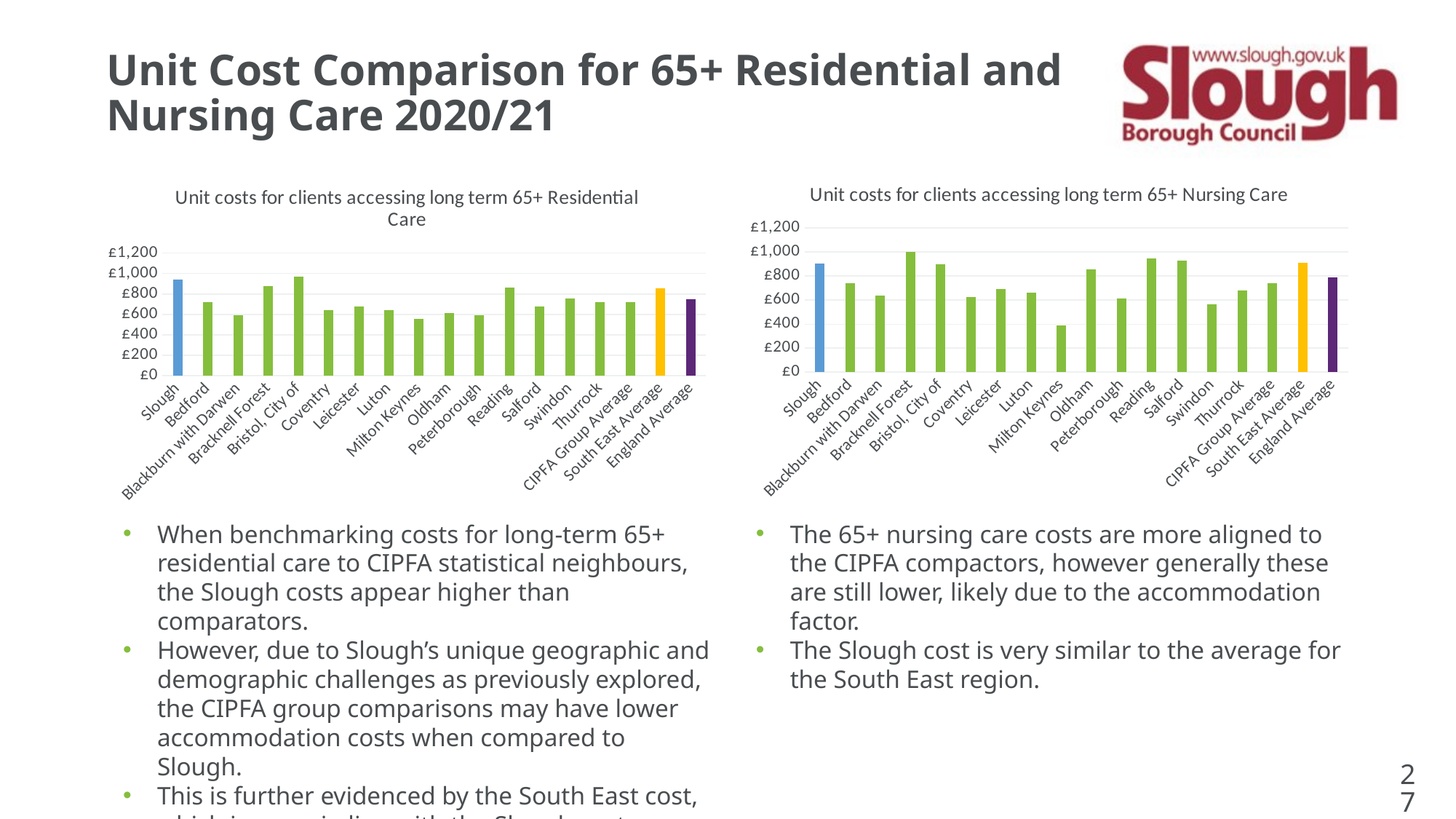
What kind of chart is the 'Unit costs for clients accessing long term 65+ Residential Care' chart? bar chart In the 'Unit costs for clients accessing long term 65+ Residential Care' chart, which is larger, the value for Slough or the value for Bedford? Slough In the 'Unit costs for clients accessing long term 65+ Nursing Care' chart, what colour is the bar for Slough? blue In the 'Unit costs for clients accessing long term 65+ Residential Care' chart, is the value for Milton Keynes greater or less than £600? less In the 'Unit costs for clients accessing long term 65+ Nursing Care' chart, is the value for Milton Keynes greater or less than £600? less In the 'Unit costs for clients accessing long term 65+ Nursing Care' chart, which category has the lowest value? Milton Keynes How many categories are shown on the x axis of the 'Unit costs for clients accessing long term 65+ Nursing Care' chart? 18 In the 'Unit costs for clients accessing long term 65+ Nursing Care' chart, which category has the highest value? Bracknell Forest In the 'Unit costs for clients accessing long term 65+ Nursing Care' chart, is the value for Slough greater or less than £800? greater What is the title of the chart on the left of the slide? Unit costs for clients accessing long term 65+ Residential Care In the 'Unit costs for clients accessing long term 65+ Nursing Care' chart, which is larger, the value for Bedford or the value for Bracknell Forest? Bracknell Forest